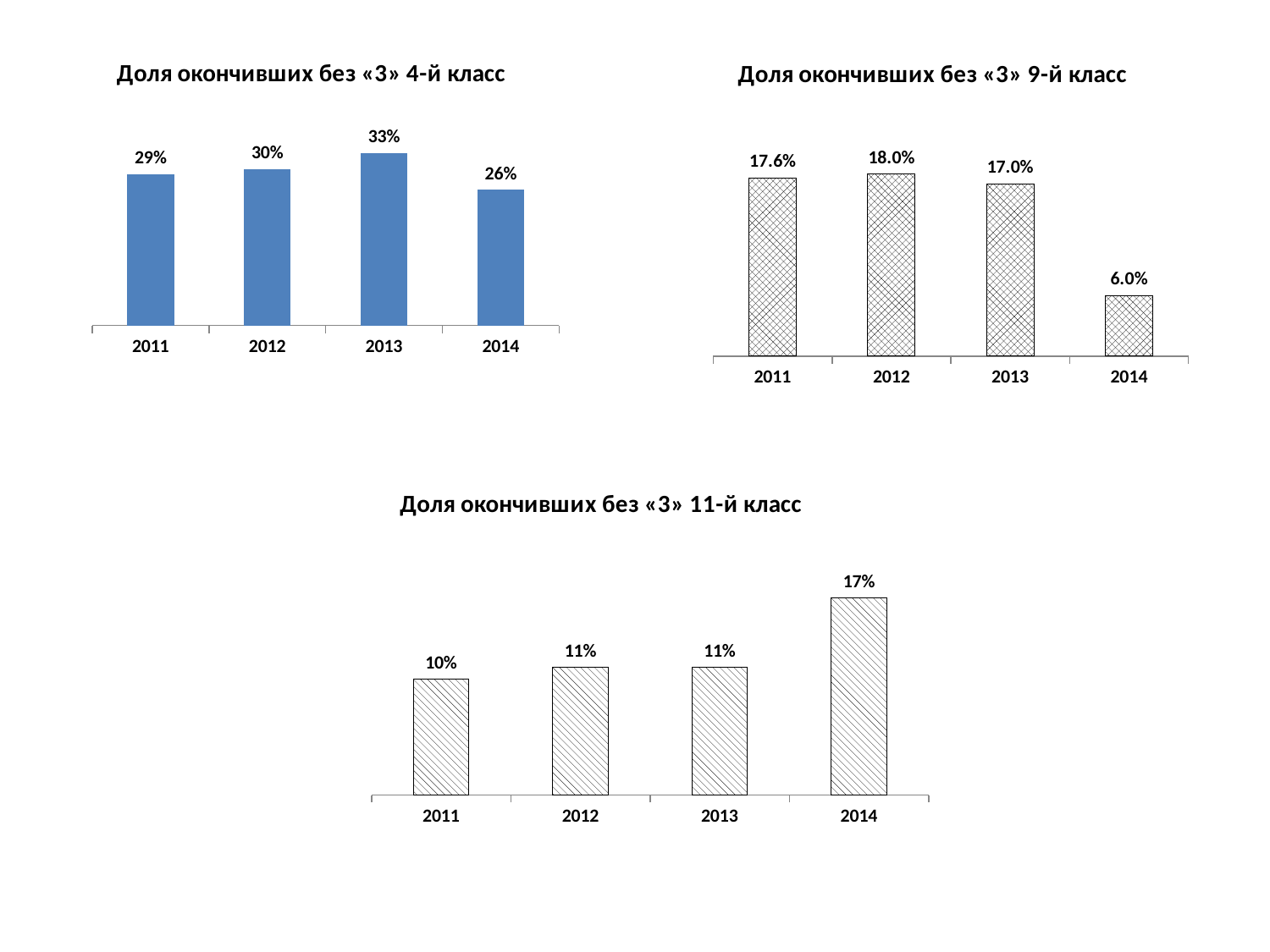
In the chart 'Доля окончивших без «3» 9-й класс', which year has the highest value? 2012 How many charts are shown on the slide? 3 In the chart 'Доля окончивших без «3» 11-й класс', which year has the lowest value? 2011 In the chart 'Доля окончивших без «3» 9-й класс', what is the difference between the values for 2013 and 2014? 11.0% In the chart 'Доля окончивших без «3» 9-й класс', what is the value for 2011? 17.6% In the chart 'Доля окончивших без «3» 4-й класс', what is the difference between the values for 2013 and 2014? 7% In the chart 'Доля окончивших без «3» 11-й класс', which is larger, the value for 2011 or the value for 2014? 2014 In the chart 'Доля окончивших без «3» 11-й класс', what is the value for 2014? 17% In the chart 'Доля окончивших без «3» 4-й класс', what is the value for 2013? 33% In the chart 'Доля окончивших без «3» 4-й класс', which year has the lowest value? 2014 In the chart 'Доля окончивших без «3» 9-й класс', how many years are shown on the x axis? 4 What kind of chart is 'Доля окончивших без «3» 11-й класс'? Bar chart